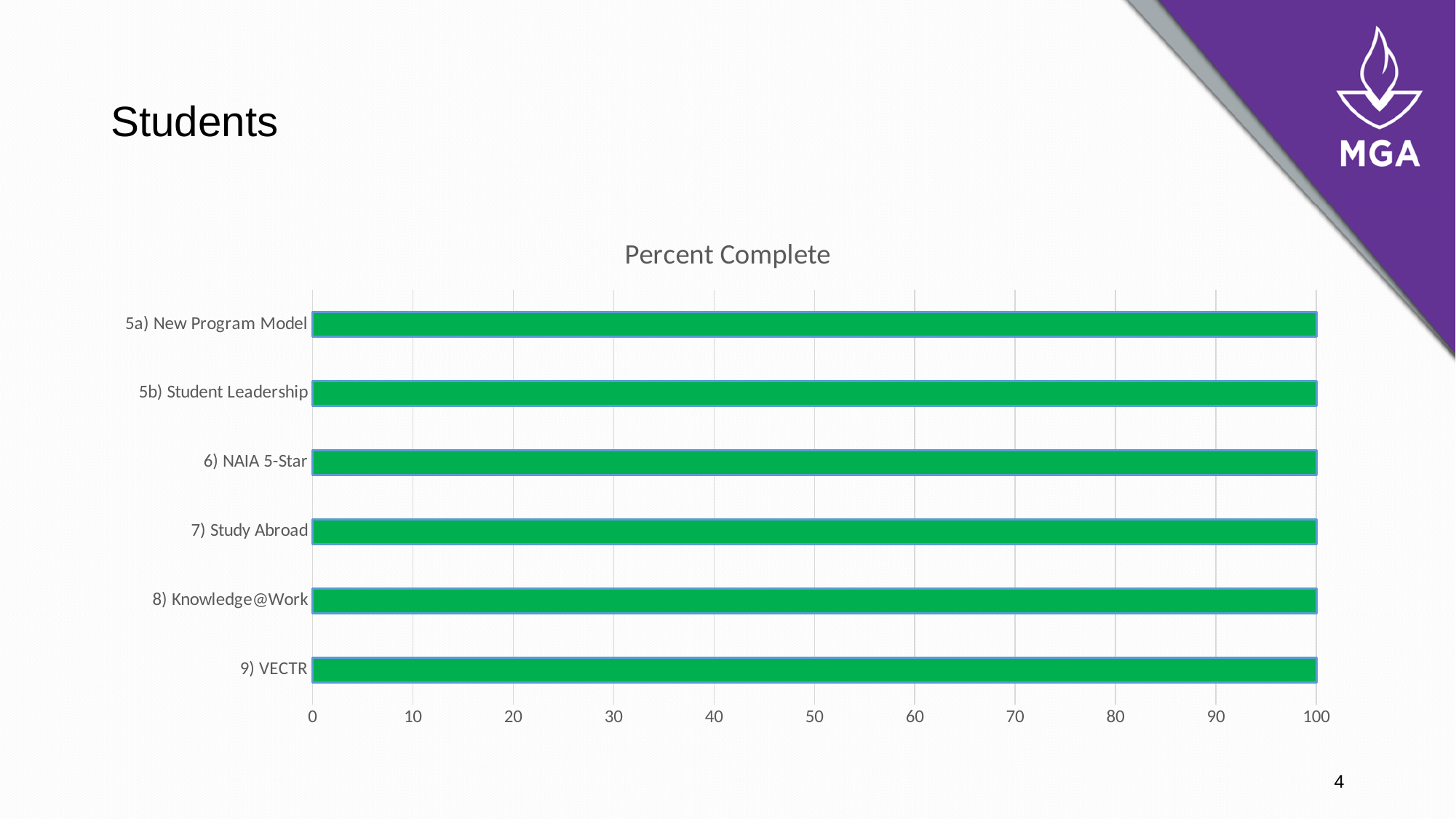
What is the value for 5a) New Program Model? 100 Which category is listed at the top of the chart? 5a) New Program Model What is the value for 7) Study Abroad? 100 What kind of chart is shown on the slide? bar chart What is the difference between the values for 5b) Student Leadership and 9) VECTR? 0 What is the title of the chart? Percent Complete How many categories are plotted in the chart? 6 Is the value for 8) Knowledge@Work greater or less than 50? greater Is the value for 6) NAIA 5-Star greater or less than 90? greater What is the highest value shown on the x axis? 100 What is the value for 9) VECTR? 100